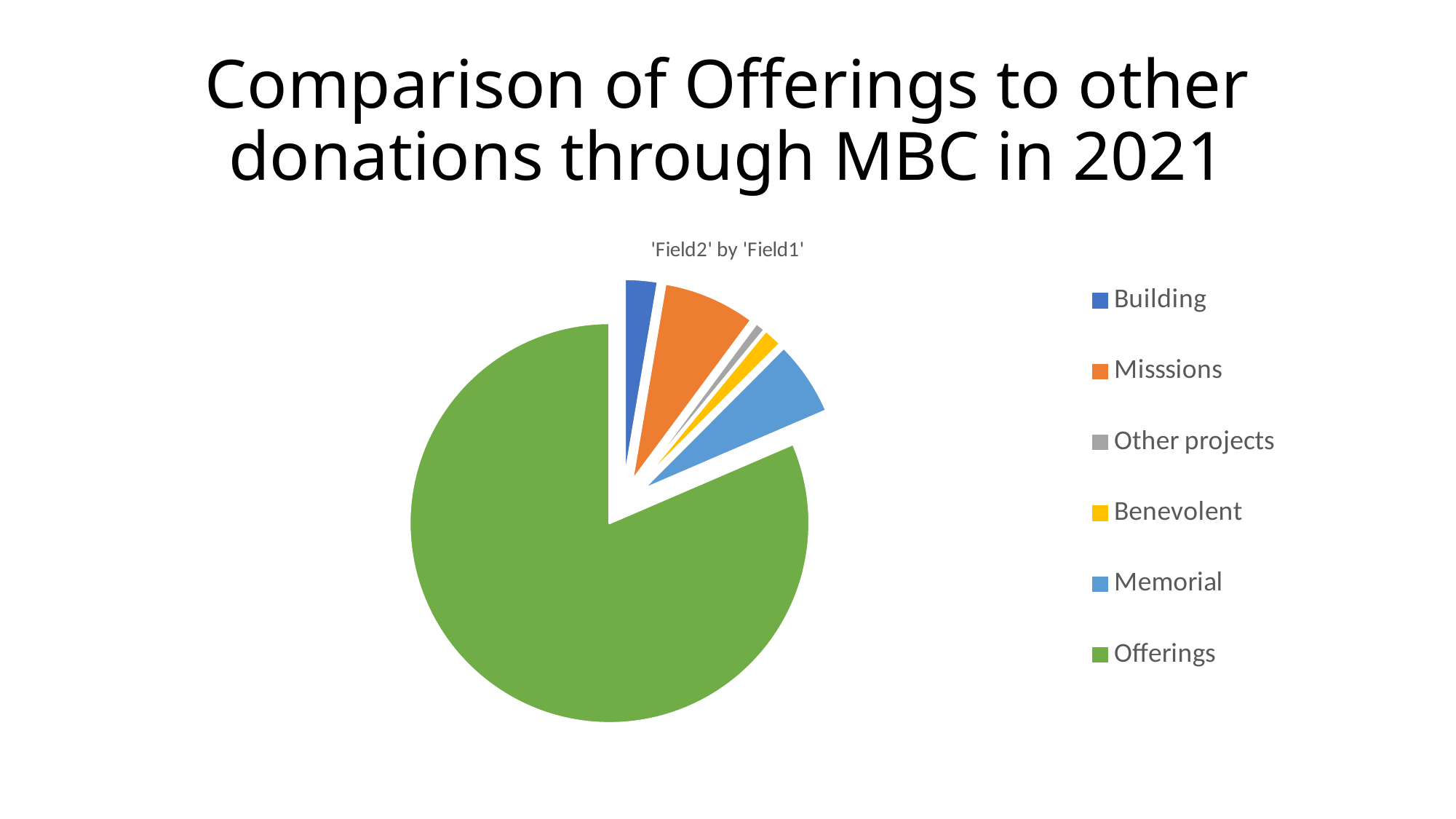
What kind of chart is shown on the slide? pie chart Which category has the largest slice of the pie chart? Offerings Which slice is larger, Memorial or Building? Memorial How many entries does the legend of the pie chart list? 6 Which slice is larger, Offerings or Misssions? Offerings How many categories does the pie chart show? 6 What colour is the Offerings slice in the pie chart? green Which slice is larger, Memorial or Benevolent? Memorial What is the title printed above the pie chart? 'Field2' by 'Field1'